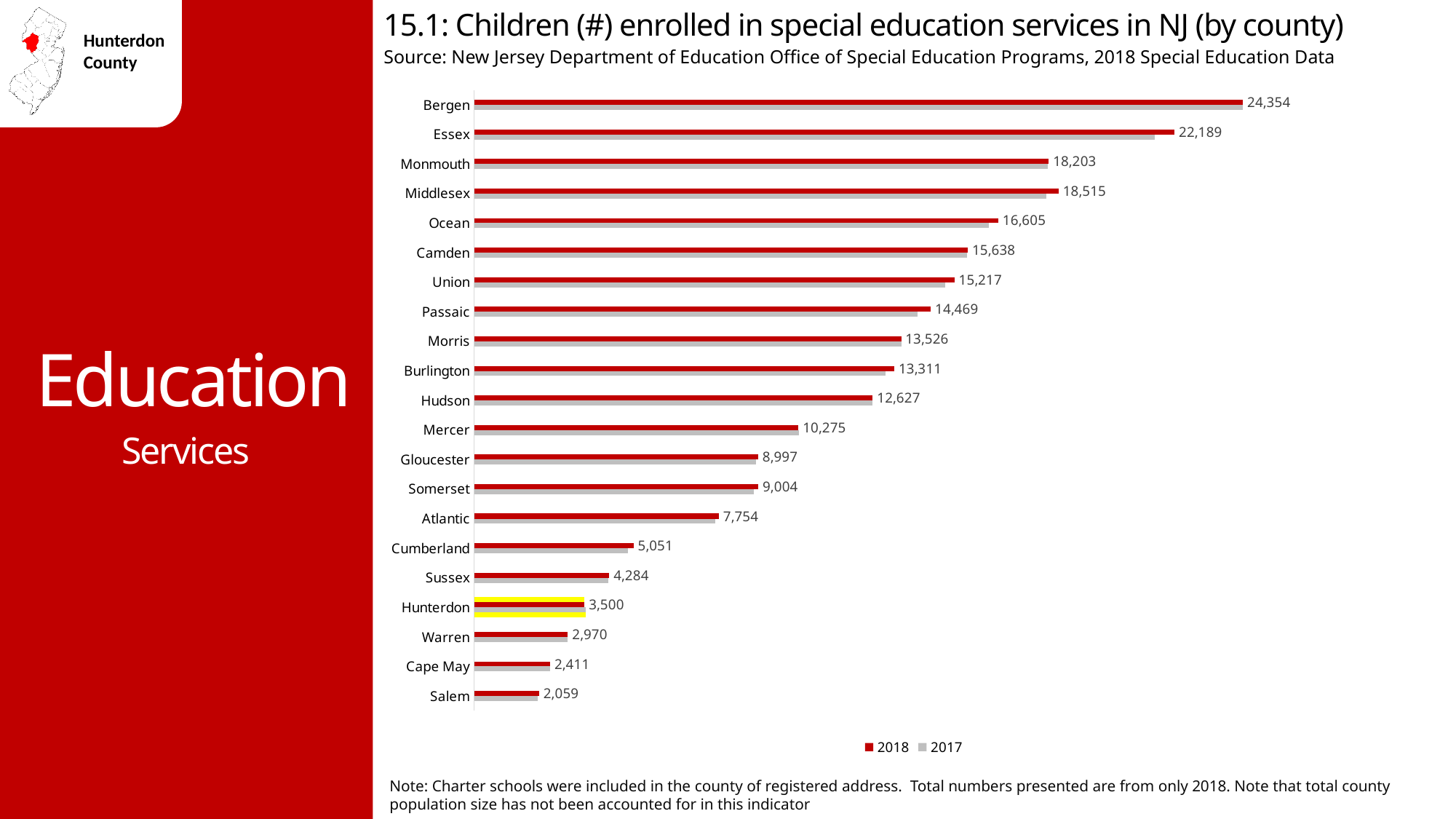
Which county's bars are highlighted in yellow on the chart? Hunterdon Which county has the lowest number of children enrolled in special education services in 2018? Salem Which county had more children enrolled in 2018, Middlesex or Monmouth? Middlesex What is the difference between the 2018 values for Hunterdon and Warren? 530 What is the 2018 value for Ocean County? 16,605 How many series does the legend list? 2 How many counties are shown in the chart? 21 What kind of chart is shown on the slide? Bar chart What is the 2018 value for Mercer County? 10,275 How many children were enrolled in special education services in Hunterdon County in 2018? 3,500 What is the difference between the 2018 values for Bergen and Essex? 2,165 Which county has the highest number of children enrolled in special education services in 2018? Bergen